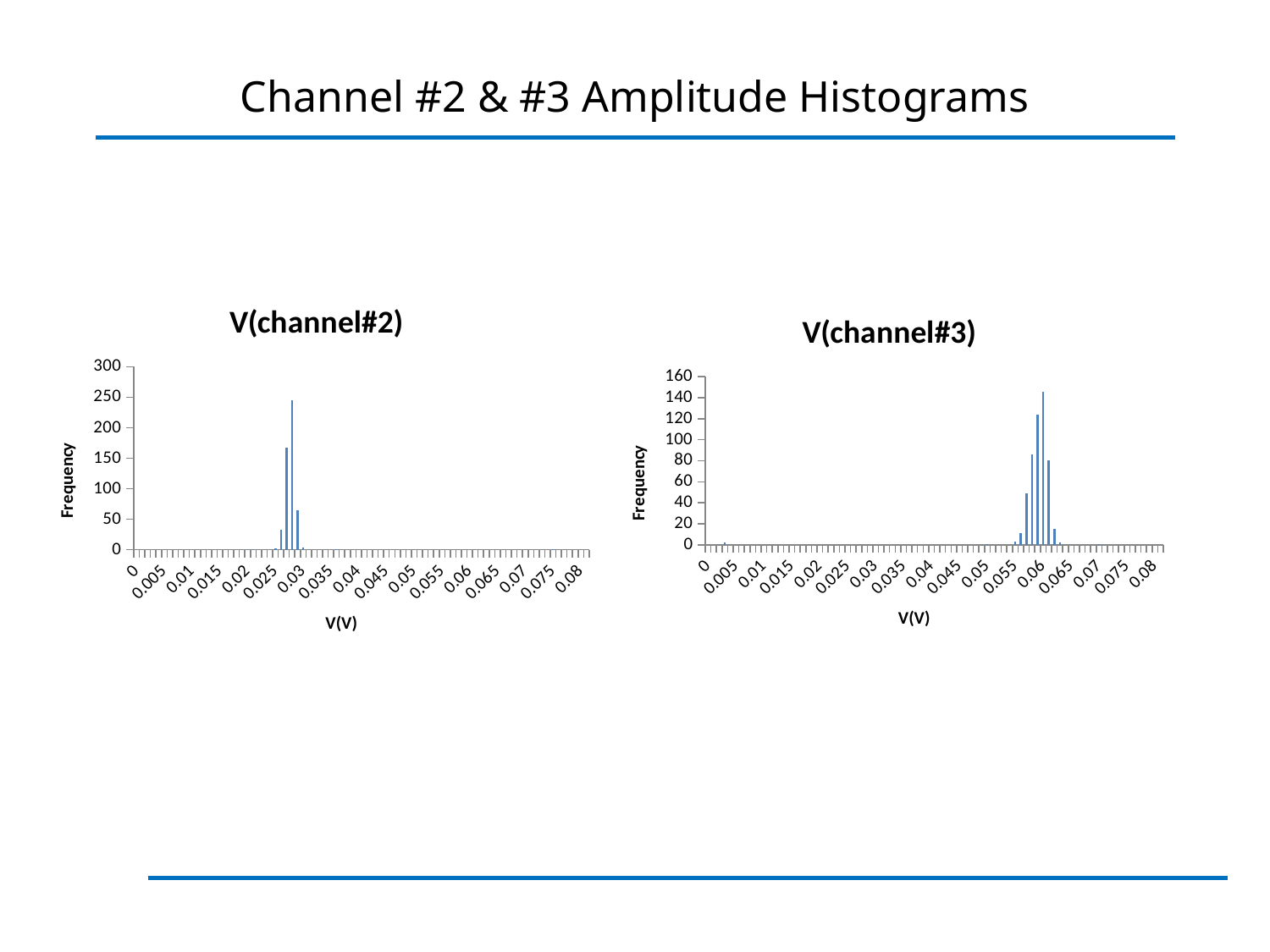
In the V(channel#2) chart, is the second tallest bar greater or less than 150? greater What is the title of the chart on the right side of the slide? V(channel#3) What kind of chart is the V(channel#2) chart? bar chart What is the highest tick value shown on the y-axis of the V(channel#3) chart? 160 Which chart has the taller peak frequency, V(channel#2) or V(channel#3)? V(channel#2) In the V(channel#2) chart, is the second tallest bar greater or less than 200? less In the V(channel#2) chart, is the tallest bar greater or less than 200? greater What is the y-axis label on the V(channel#2) chart? Frequency Is the peak of the V(channel#3) histogram located near 0.03 or near 0.06 on the x-axis? near 0.06